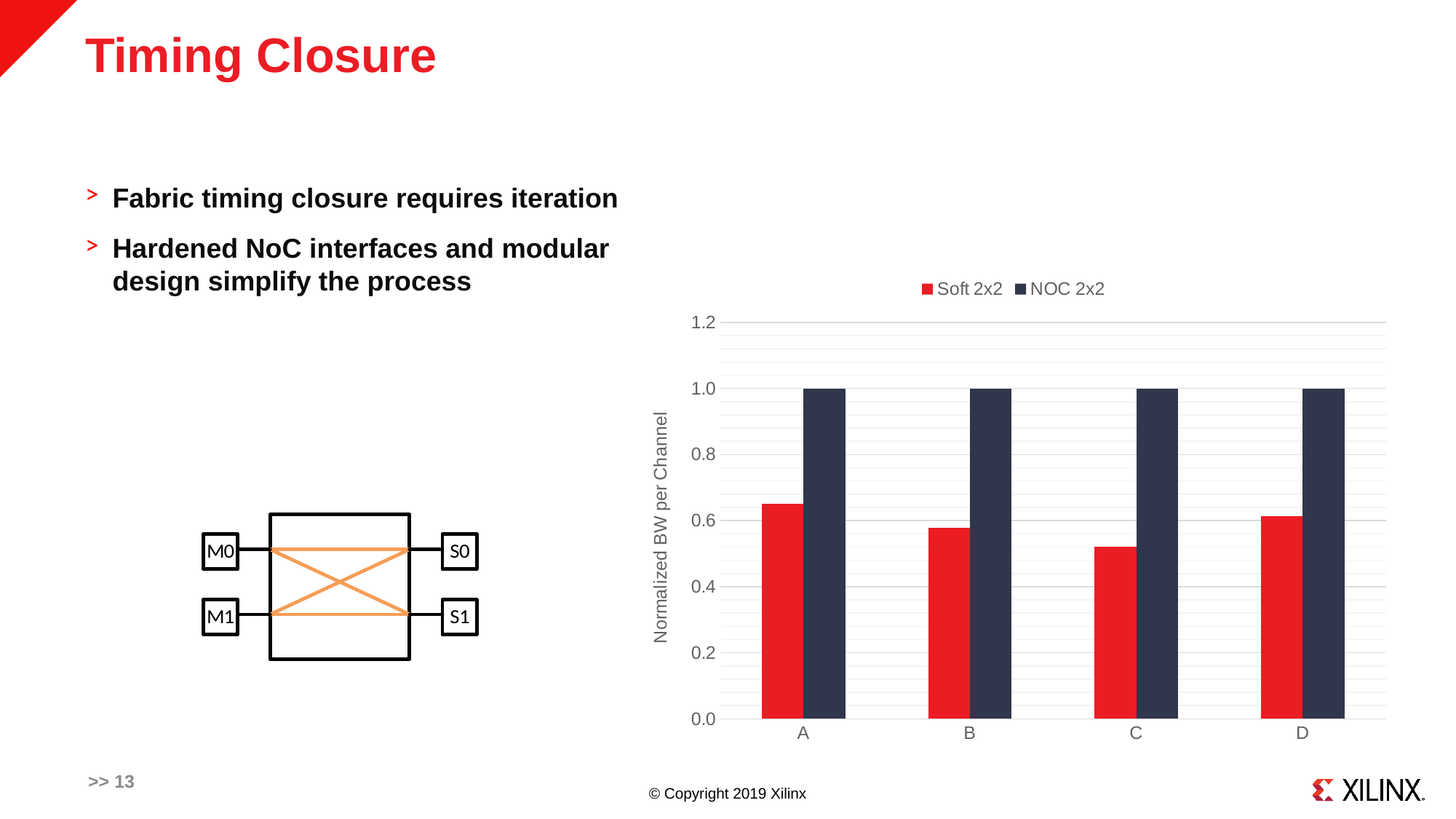
What is the value of NOC 2x2 for category C? 1.0 How many categories are shown on the x axis of the chart? 4 Is the Soft 2x2 value for category C greater or less than 0.6? less What is the label of the chart's vertical axis? Normalized BW per Channel For category B, which series has the larger value, Soft 2x2 or NOC 2x2? NOC 2x2 Is the Soft 2x2 value for category A greater or less than 0.6? greater Which is larger, the Soft 2x2 value for A or the Soft 2x2 value for C? A How many series does the chart's legend list? 2 Is the Soft 2x2 value for category C greater or less than 0.4? greater Which category has the lowest Soft 2x2 value? C What kind of chart is shown on the slide? bar chart What is the value of NOC 2x2 for category A? 1.0